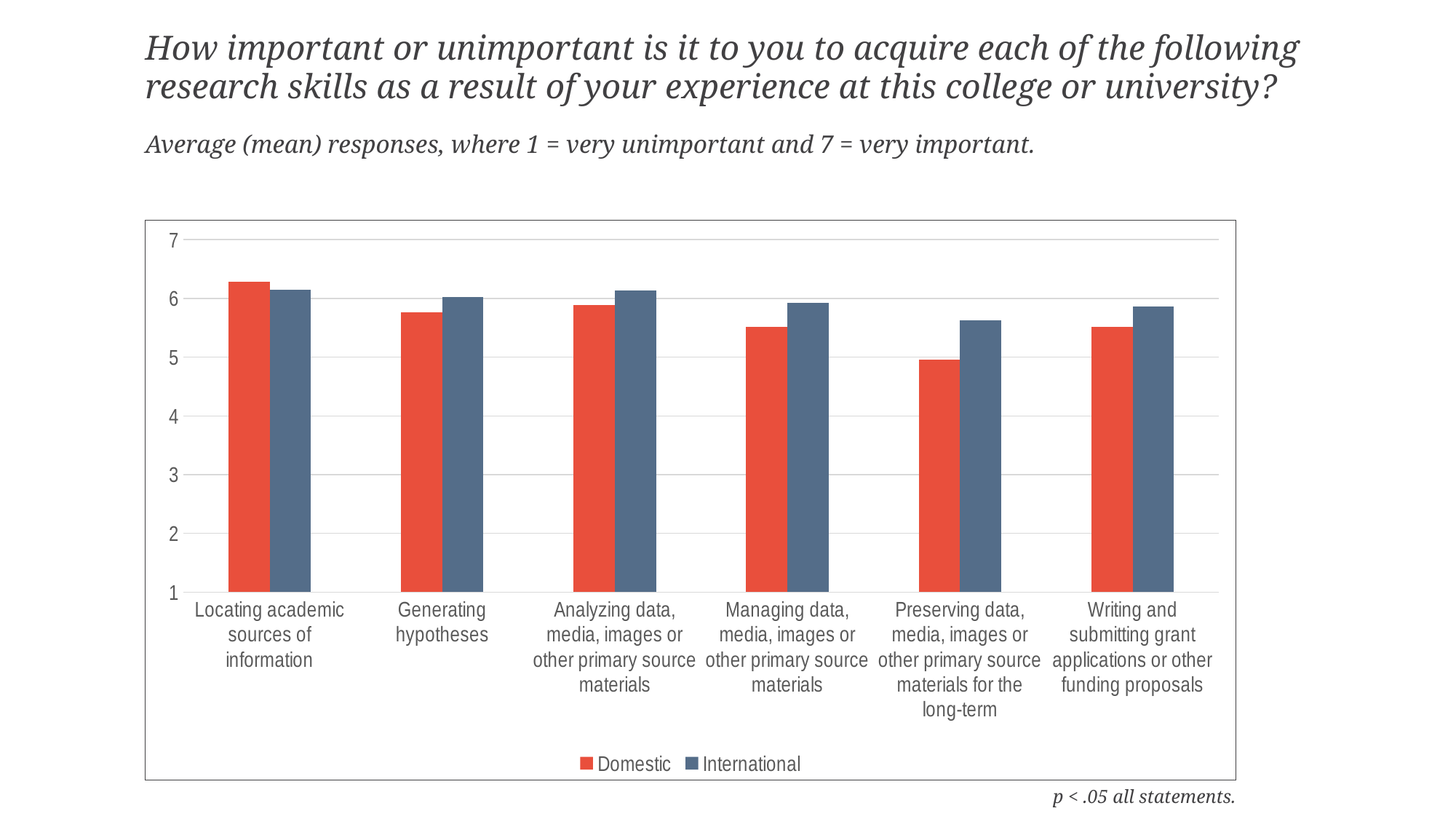
What kind of chart is shown on the slide? bar chart Is the Domestic value for 'Locating academic sources of information' greater or less than 6? greater Which research skill has the lowest Domestic value? Preserving data, media, images or other primary source materials for the long-term Which research skill has the lowest International value? Preserving data, media, images or other primary source materials for the long-term For 'Preserving data, media, images or other primary source materials for the long-term', which is larger: the Domestic or the International value? International For 'Locating academic sources of information', which is larger: the Domestic or the International value? Domestic Is the Domestic value for 'Generating hypotheses' greater or less than 6? less How many series does the chart's legend list? 2 Which research skill has the highest Domestic value? Locating academic sources of information Which colour represents the International series in the chart? blue Is the International value for 'Preserving data, media, images or other primary source materials for the long-term' greater or less than 5? greater How many research skills (categories) are shown on the x axis of the chart? 6